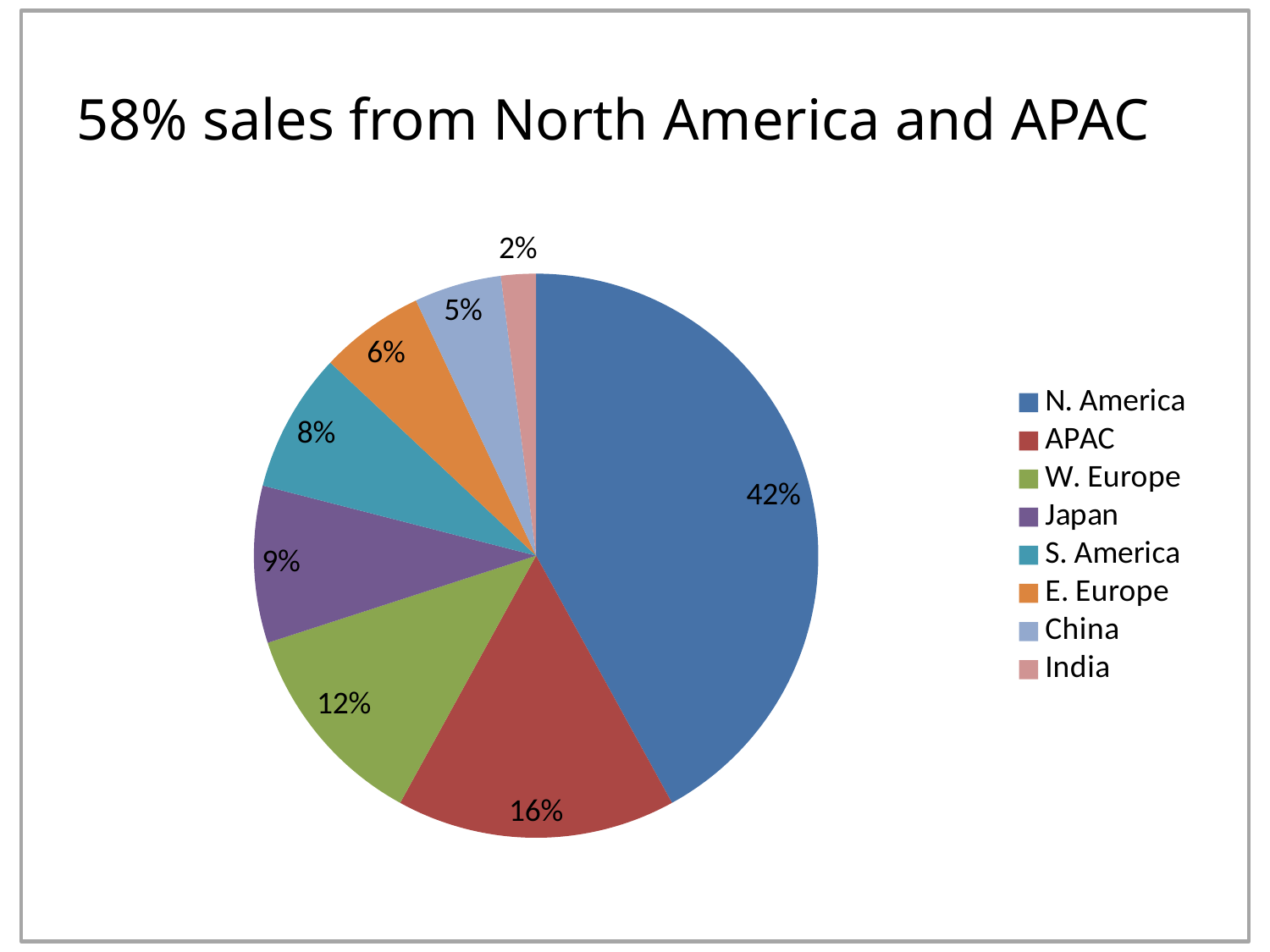
Which region has the smallest share of sales? India What share of sales does N. America account for? 42% What is the difference in percentage points between N. America and APAC? 26 What is the value for E. Europe? 6% Which region has the largest share of sales? N. America What type of chart is shown on the slide? Pie chart What percentage is shown for S. America? 8% Which has a larger share, China or Japan? Japan What percentage of sales comes from APAC? 16% What is the value shown for W. Europe? 12% What share of sales does Japan have? 9% How many regions are shown in the pie chart? 8